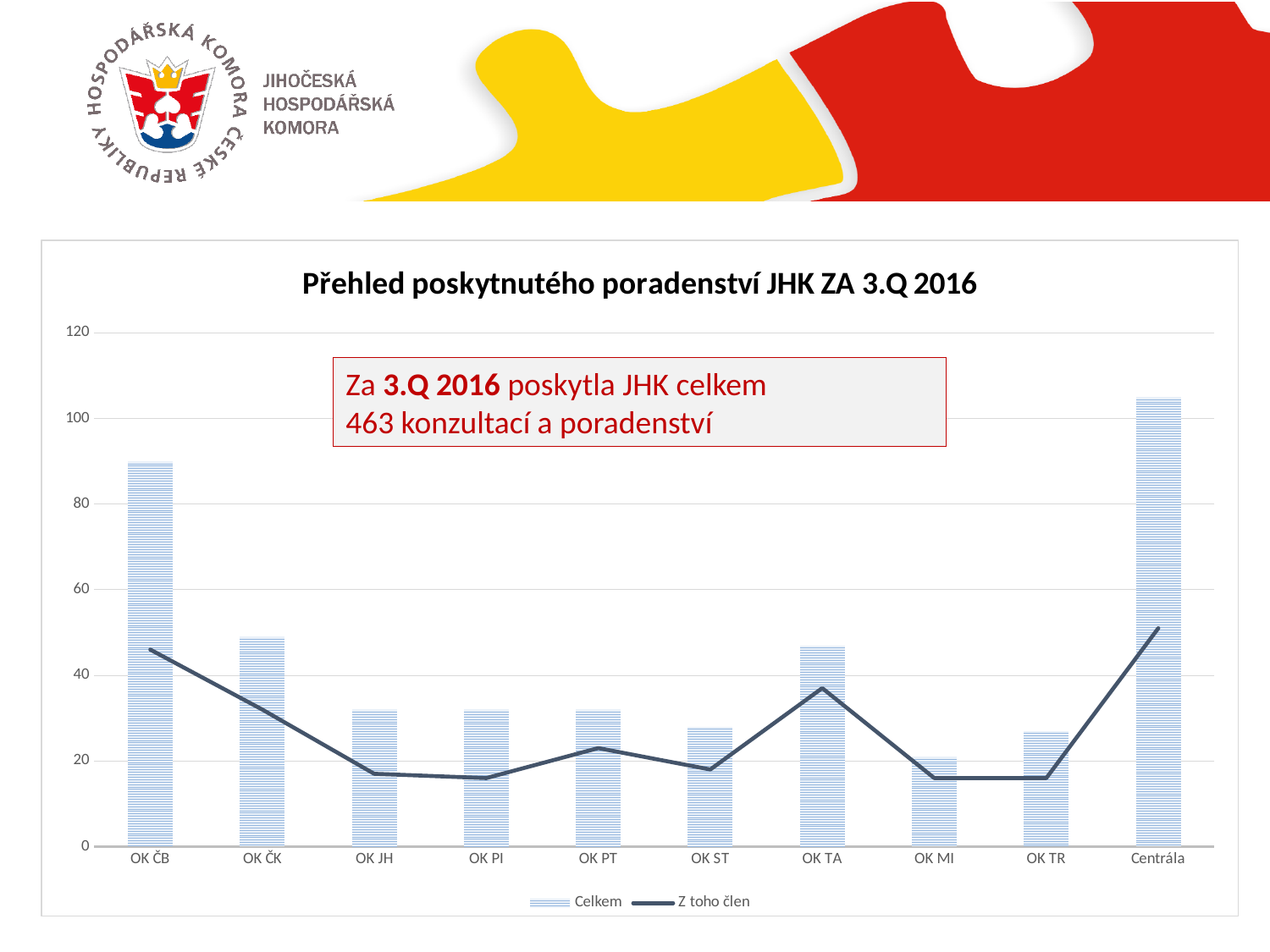
Which has the larger Z toho člen value, OK TA or OK PT? OK TA Which has the larger Celkem value, OK ČB or OK ČK? OK ČB How many categories are shown on the x axis? 10 Is the Z toho člen value for OK JH greater or less than 20? less Is the Celkem value for OK ČB greater or less than 80? greater What are the two series named in the legend? Celkem and Z toho člen What is the title of the chart? Přehled poskytnutého poradenství JHK ZA 3.Q 2016 Which category has the highest value on the Z toho člen line? Centrála Which category has the highest Celkem bar? Centrála How many series does the chart legend list? 2 Is the Celkem value for Centrála greater or less than 100? greater Which category has the lowest Celkem bar? OK MI